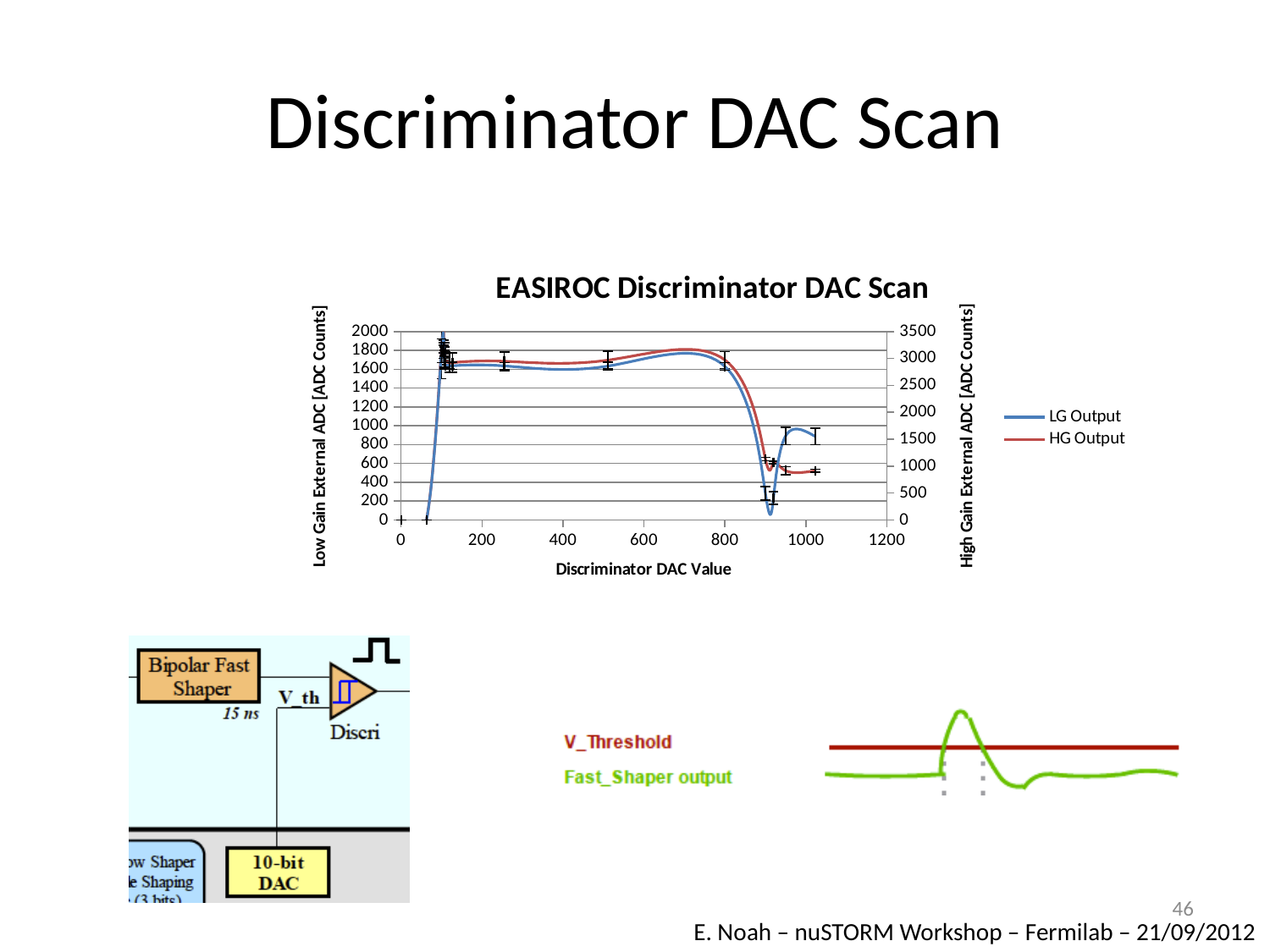
What kind of chart is the EASIROC Discriminator DAC Scan chart? line chart What is the title of the chart on the slide? EASIROC Discriminator DAC Scan In the EASIROC Discriminator DAC Scan chart, is the LG Output value at a Discriminator DAC Value of 400 greater or less than 1000 on the left axis? greater What is the x-axis title of the EASIROC Discriminator DAC Scan chart? Discriminator DAC Value In the EASIROC Discriminator DAC Scan chart, which series is plotted against the right-hand axis labelled High Gain External ADC [ADC Counts]? HG Output In the EASIROC Discriminator DAC Scan chart, is the LG Output value at a Discriminator DAC Value of about 900 greater or less than 500 on the left axis? less How many series does the legend of the EASIROC Discriminator DAC Scan chart list? 2 In the EASIROC Discriminator DAC Scan chart, does the LG Output rise or fall as the Discriminator DAC Value goes from 0 to 100? rise In the EASIROC Discriminator DAC Scan chart, is the HG Output value at a Discriminator DAC Value of 700 greater or less than 2500 on the right axis? greater In the EASIROC Discriminator DAC Scan chart, does the LG Output rise or fall as the Discriminator DAC Value goes from 800 to 900? fall